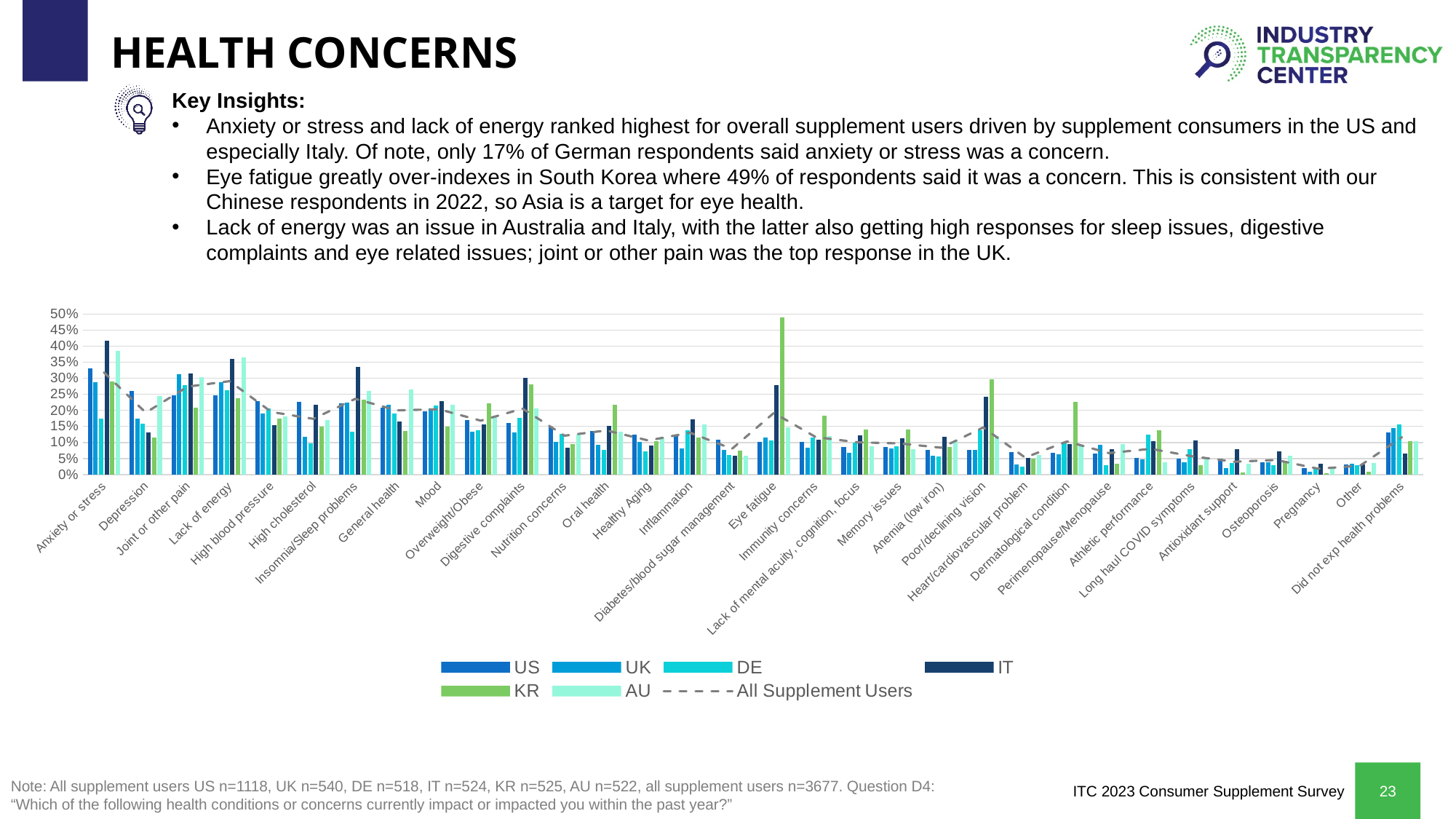
How many health concern categories are shown on the x axis? 32 Which series is drawn as a dashed line rather than bars? All Supplement Users Is the DE value for Anxiety or stress greater or less than 20%? less Is the IT value for Lack of energy greater or less than 30%? greater Is the KR value for Eye fatigue greater or less than 45%? greater Which country has the highest bar for Eye fatigue? KR How many series does the legend list? 7 What kind of chart is shown on the slide? combination bar and line chart Which country has the highest bar for Anxiety or stress? IT For Eye fatigue, which is larger: the KR value or the US value? KR